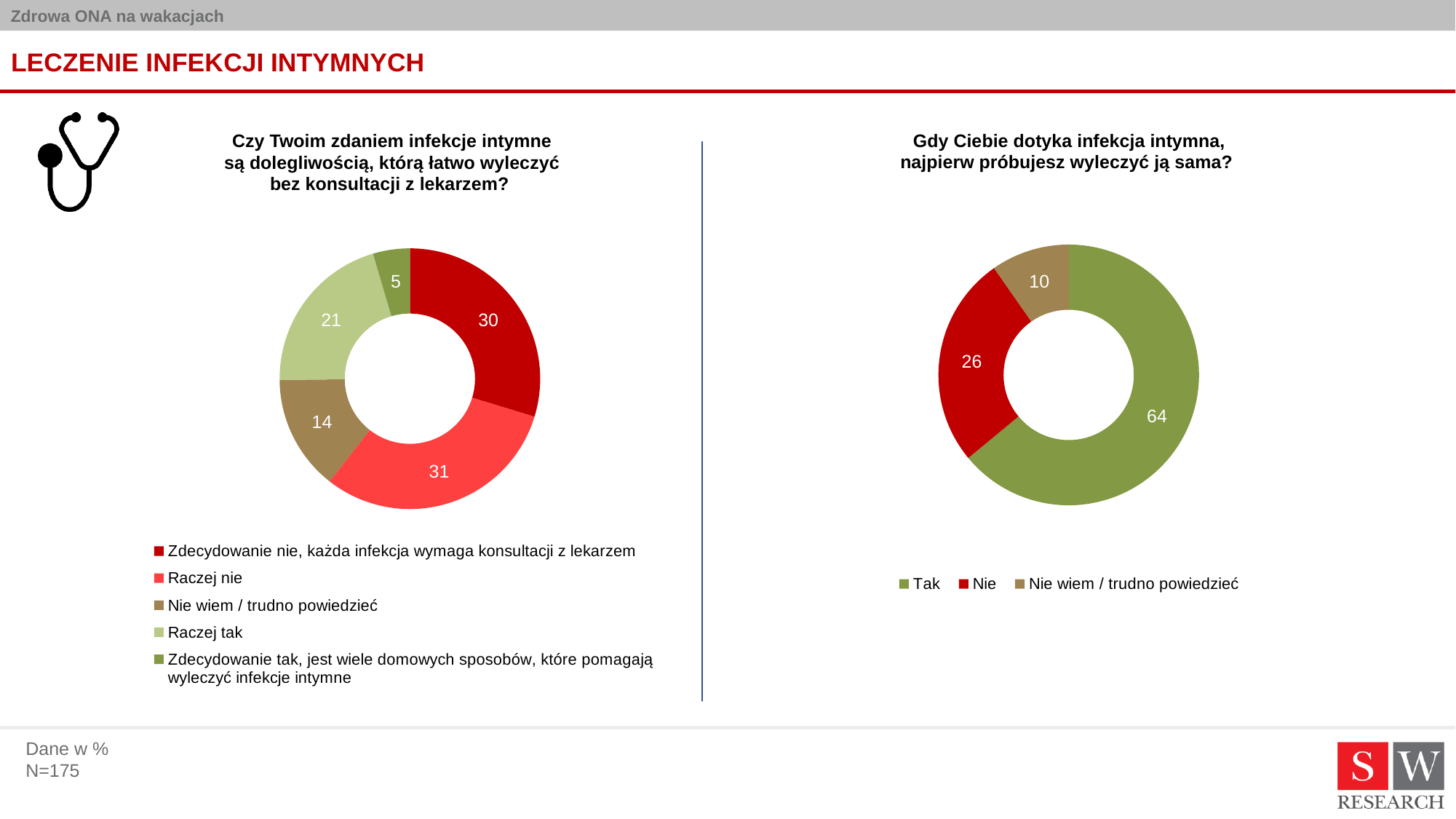
In the right chart ("Gdy Ciebie dotyka infekcja intymna..."), what is the value for "Nie"? 26 In the right chart ("Gdy Ciebie dotyka infekcja intymna..."), what is the difference between "Tak" and "Nie"? 38 In the left chart ("Czy Twoim zdaniem infekcje intymne..."), how many categories does the legend list? 5 In the left chart ("Czy Twoim zdaniem infekcje intymne..."), what is the value for "Zdecydowanie nie, każda infekcja wymaga konsultacji z lekarzem"? 30 In the right chart ("Gdy Ciebie dotyka infekcja intymna..."), what is the value for "Tak"? 64 In the right chart ("Gdy Ciebie dotyka infekcja intymna..."), how many categories does the legend list? 3 In the left chart ("Czy Twoim zdaniem infekcje intymne..."), what is the value for "Raczej nie"? 31 In the left chart ("Czy Twoim zdaniem infekcje intymne..."), which is larger: "Raczej tak" or "Nie wiem / trudno powiedzieć"? Raczej tak What type of chart is used on the left side of the slide ("Czy Twoim zdaniem infekcje intymne...")? Pie (donut) chart In the right chart ("Gdy Ciebie dotyka infekcja intymna..."), which category has the highest value? Tak In the left chart ("Czy Twoim zdaniem infekcje intymne..."), what is the difference between "Raczej tak" and "Nie wiem / trudno powiedzieć"? 7 In the left chart ("Czy Twoim zdaniem infekcje intymne..."), which category has the lowest value? Zdecydowanie tak, jest wiele domowych sposobów, które pomagają wyleczyć infekcje intymne